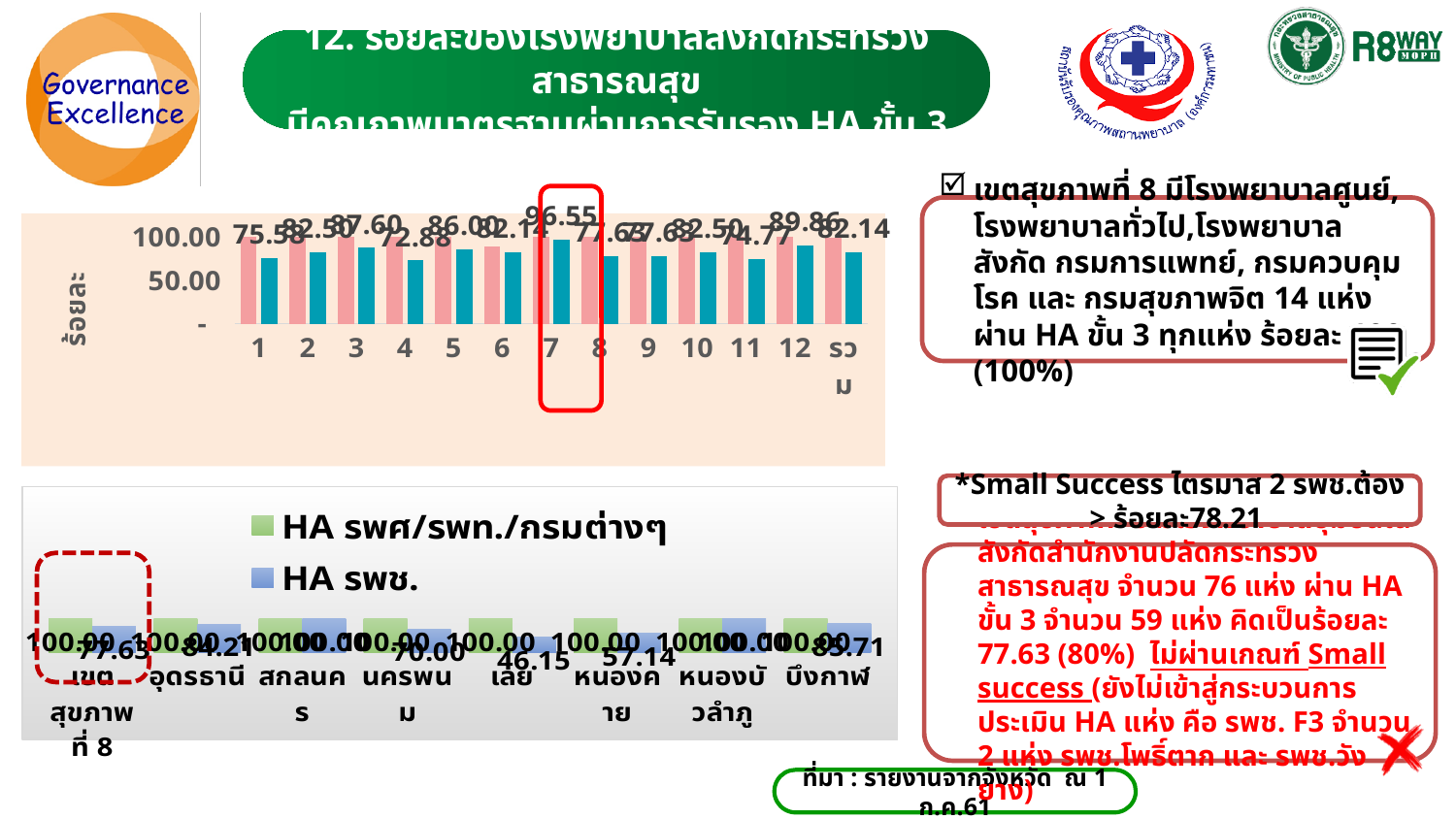
In the bottom chart, how many categories are shown on the x axis? 8 In the bottom chart, which category has the lowest HA รพช. value? เลย In the bottom chart, what is the HA รพช. value for เขตสุขภาพที่ 8? 77.63 In the top chart, what is the highlighted data label for category 7? 96.55 In the bottom chart, what is the difference between the HA รพศ/รพท./กรมต่างๆ value and the HA รพช. value for เขตสุขภาพที่ 8? 22.37 In the bottom chart, what is the HA รพช. value for อุดรธานี? 84.21 What kind of chart is the top chart? bar chart In the bottom chart, which has the larger HA รพช. value, อุดรธานี or นครพนม? อุดรธานี In the bottom chart, what is the HA รพช. value for เลย? 46.15 In the top chart, how many categories are shown on the x axis? 13 In the bottom chart, how many series does the legend list? 2 In the bottom chart, which series is shown in green? HA รพศ/รพท./กรมต่างๆ